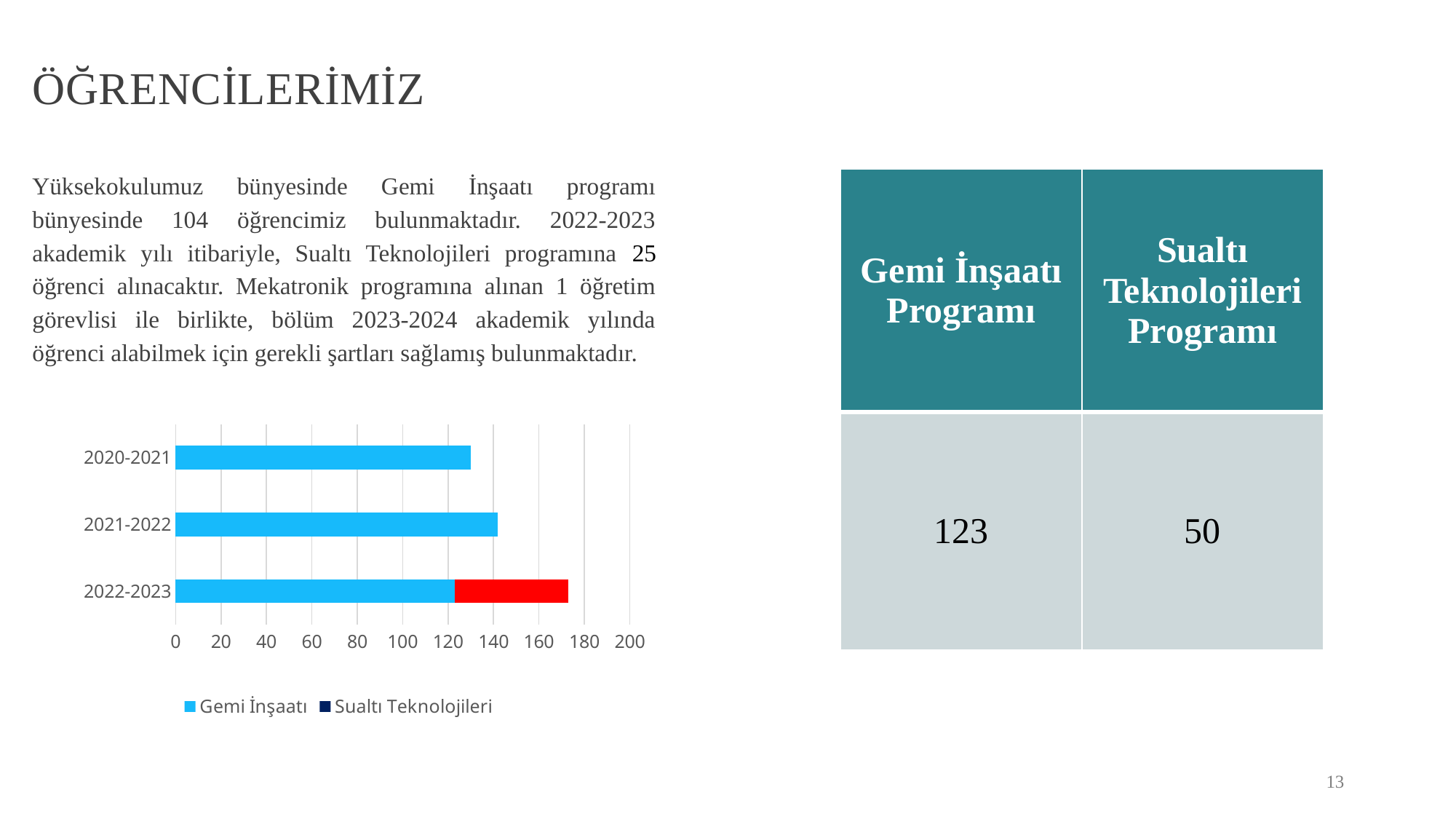
Which academic year has the shortest total bar in the chart? 2020-2021 What kind of chart is shown on the slide? bar chart How many series does the chart legend list? 2 Which academic year is the only one with a Sualtı Teknolojileri segment in the chart? 2022-2023 Do the total bar lengths rise or fall from 2020-2021 to 2022-2023? rise Is the Gemi İnşaatı value for 2020-2021 greater or less than 140? less Which is larger, the Gemi İnşaatı value for 2021-2022 or for 2020-2021? 2021-2022 Is the Gemi İnşaatı value for 2020-2021 greater or less than 120? greater Is the total bar length for 2022-2023 greater or less than 160? greater Which series are listed in the chart legend? Gemi İnşaatı and Sualtı Teknolojileri Which academic year has the longest total bar in the chart? 2022-2023 How many academic-year categories does the chart show? 3